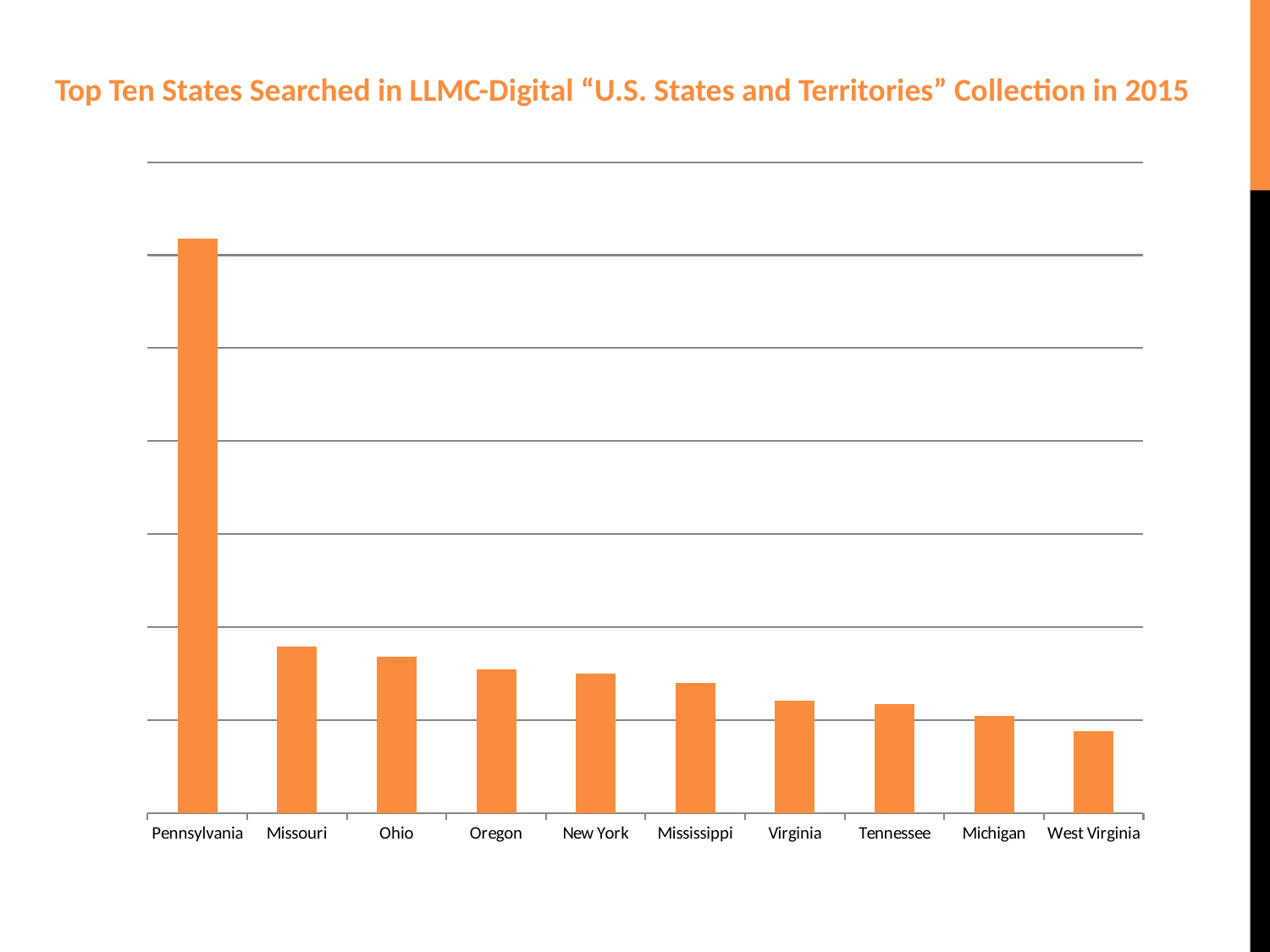
Which has the larger value, Ohio or Oregon? Ohio Which has the larger value, Michigan or West Virginia? Michigan Do the bar values rise or fall moving from left to right along the x axis? Fall Which state has the lowest bar in the chart? West Virginia Which state has the highest bar in the chart? Pennsylvania Which state is listed second on the x axis? Missouri Which has the larger value, Pennsylvania or Missouri? Pennsylvania How many states are shown on the x axis of the chart? 10 What is the title of the chart? Top Ten States Searched in LLMC-Digital "U.S. States and Territories" Collection in 2015 What kind of chart is shown on the slide? Bar chart